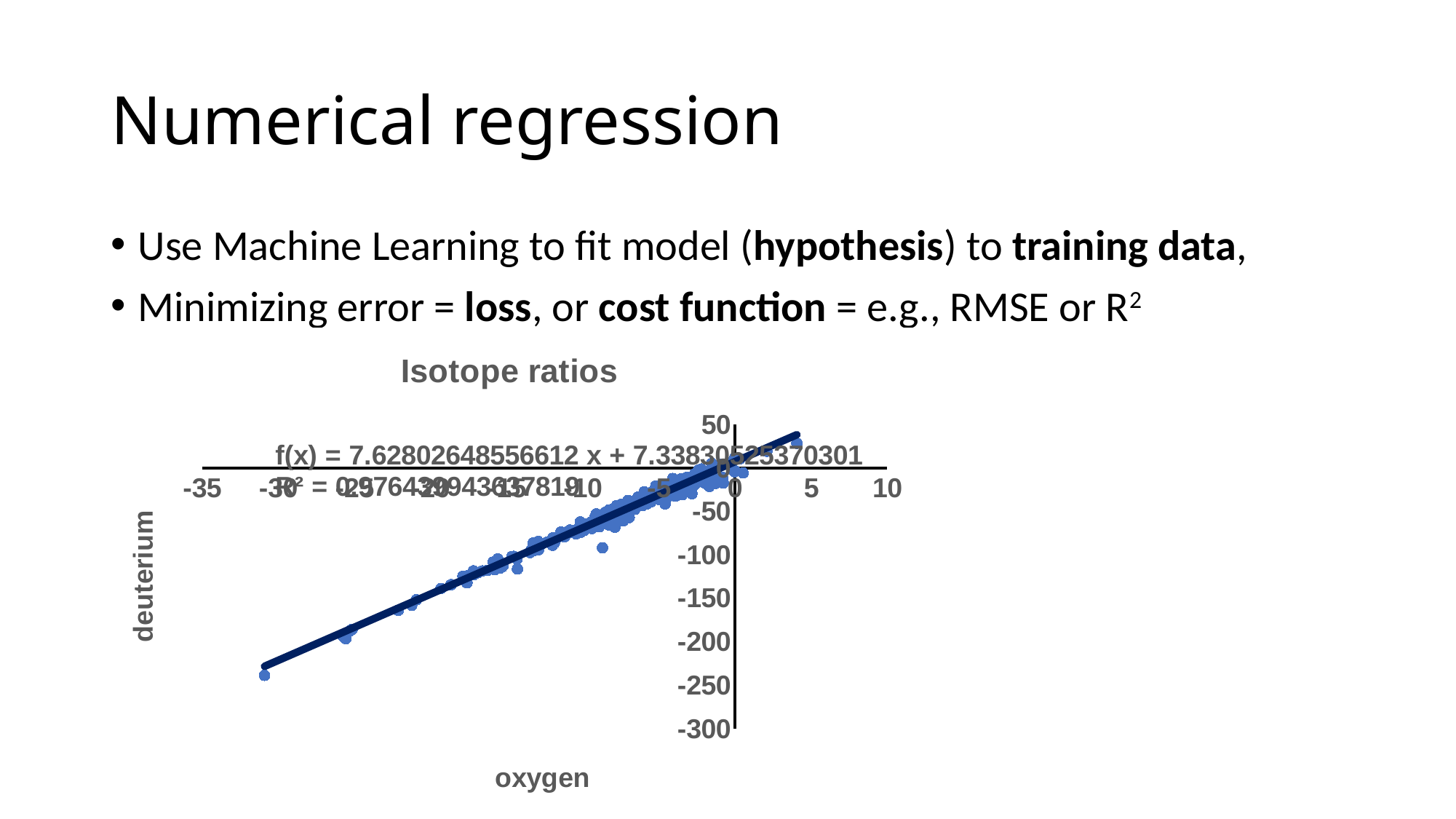
Is the deuterium value of the data points near oxygen = 0 greater or less than -50? greater What is the intercept of the fitted line shown in the chart's equation? 7.33830525370301 Is the deuterium value of the data point near oxygen = -20 greater or less than -100? less Is the deuterium value of the lowest data point (near oxygen = -30) greater or less than -200? less What is the highest tick value shown on the x axis? 10 What is the slope of the fitted line shown in the chart's equation? 7.62802648556612 What is the label of the x axis of the chart? oxygen Do the deuterium values rise or fall as oxygen increases along the x axis? rise What is the lowest tick value shown on the y axis? -300 What is the title of the chart? Isotope ratios What kind of chart is shown on the slide? scatter chart